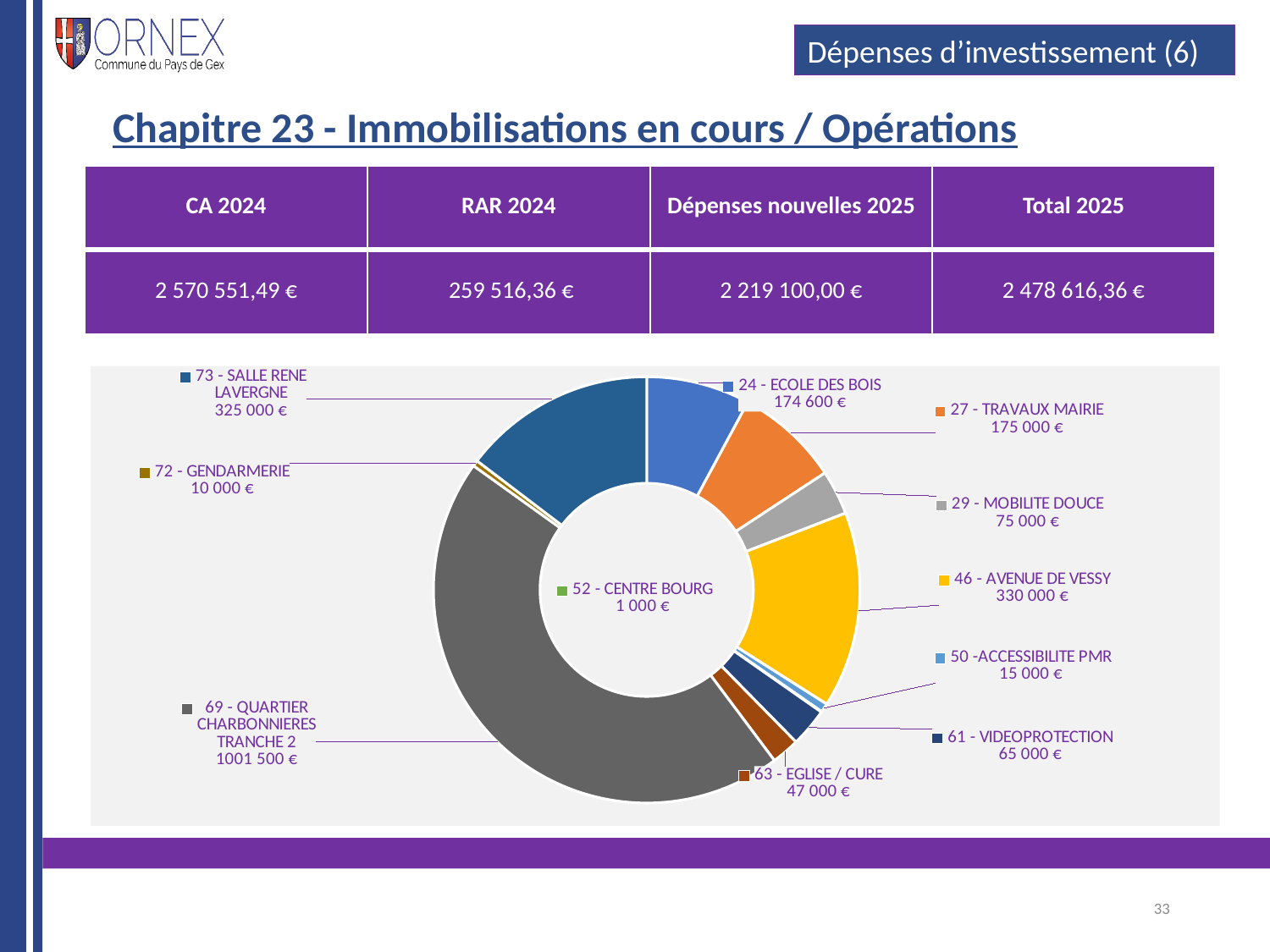
What colour is the slice for 46 - AVENUE DE VESSY in the doughnut chart? yellow What is the difference between the values for 46 - AVENUE DE VESSY and 73 - SALLE RENE LAVERGNE? 5 000 € How many categories (operations) are shown in the doughnut chart? 11 What is the value for 29 - MOBILITE DOUCE in the doughnut chart? 75 000 € What is the value for 24 - ECOLE DES BOIS in the doughnut chart? 174 600 € What share of the total in the doughnut chart does 69 - QUARTIER CHARBONNIERES TRANCHE 2 represent? 45.1% Which is larger in the doughnut chart: 61 - VIDEOPROTECTION or 63 - EGLISE / CURE? 61 - VIDEOPROTECTION What is the value for 63 - EGLISE / CURE in the doughnut chart? 47 000 € Which category has the largest value in the doughnut chart? 69 - QUARTIER CHARBONNIERES TRANCHE 2 What kind of chart is shown on the slide? doughnut chart What is the value for 73 - SALLE RENE LAVERGNE in the doughnut chart? 325 000 € Which category has the smallest value in the doughnut chart? 52 - CENTRE BOURG